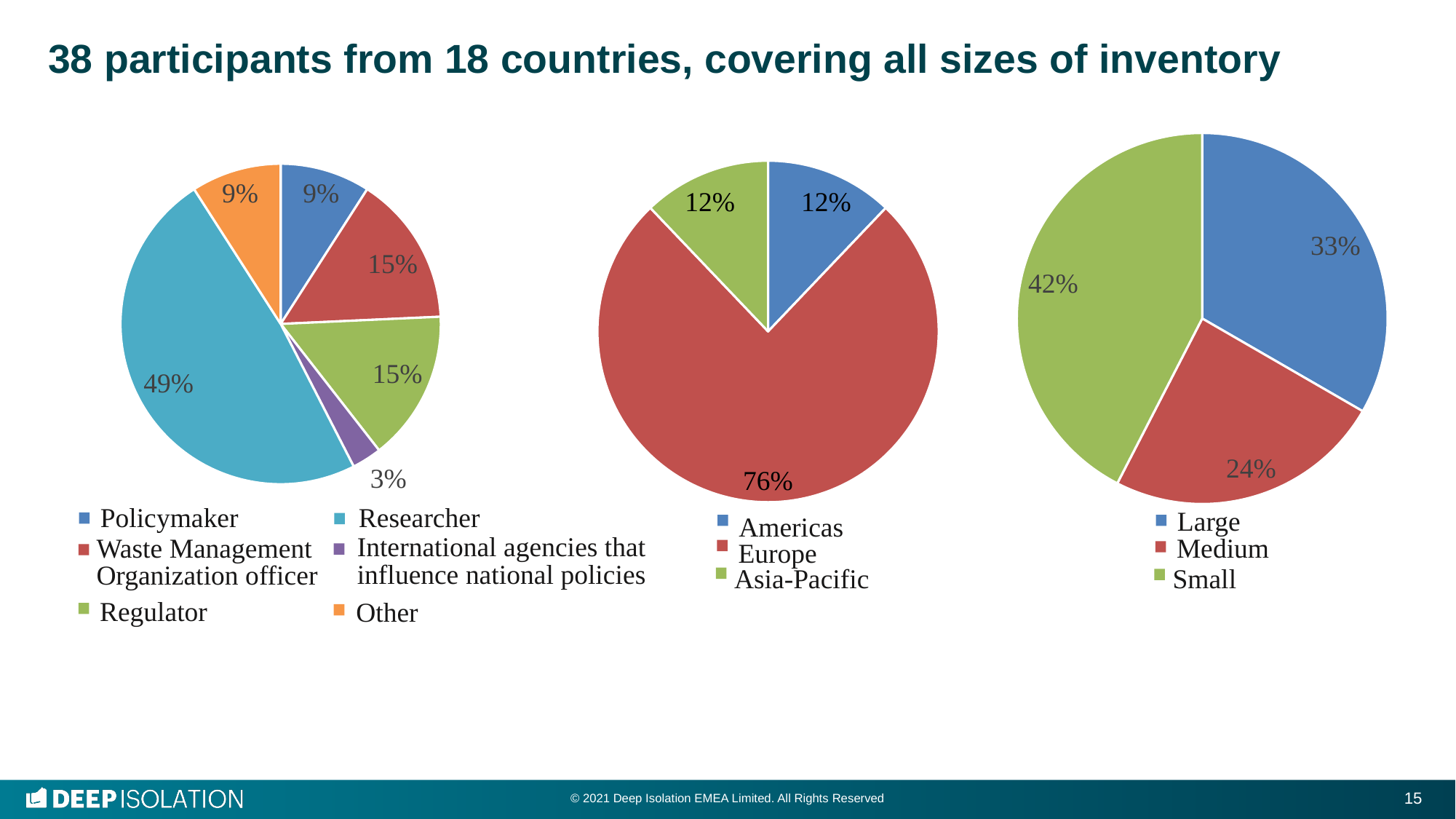
In the right pie chart, what share is Medium? 24% In the right pie chart, which is larger, Large or Small? Small In the left pie chart, what share is Researcher? 49% In the left pie chart, what share is International agencies that influence national policies? 3% What type of chart is the middle chart? Pie chart In the middle pie chart, what is the difference between the Europe share and the Americas share? 64% How many categories does the legend of the left pie chart list? 6 In the middle pie chart, which region has the largest slice? Europe In the left pie chart, which category has the smallest slice? International agencies that influence national policies In the left pie chart, which category has the largest slice? Researcher In the right pie chart, what is the difference between the Small share and the Medium share? 18%